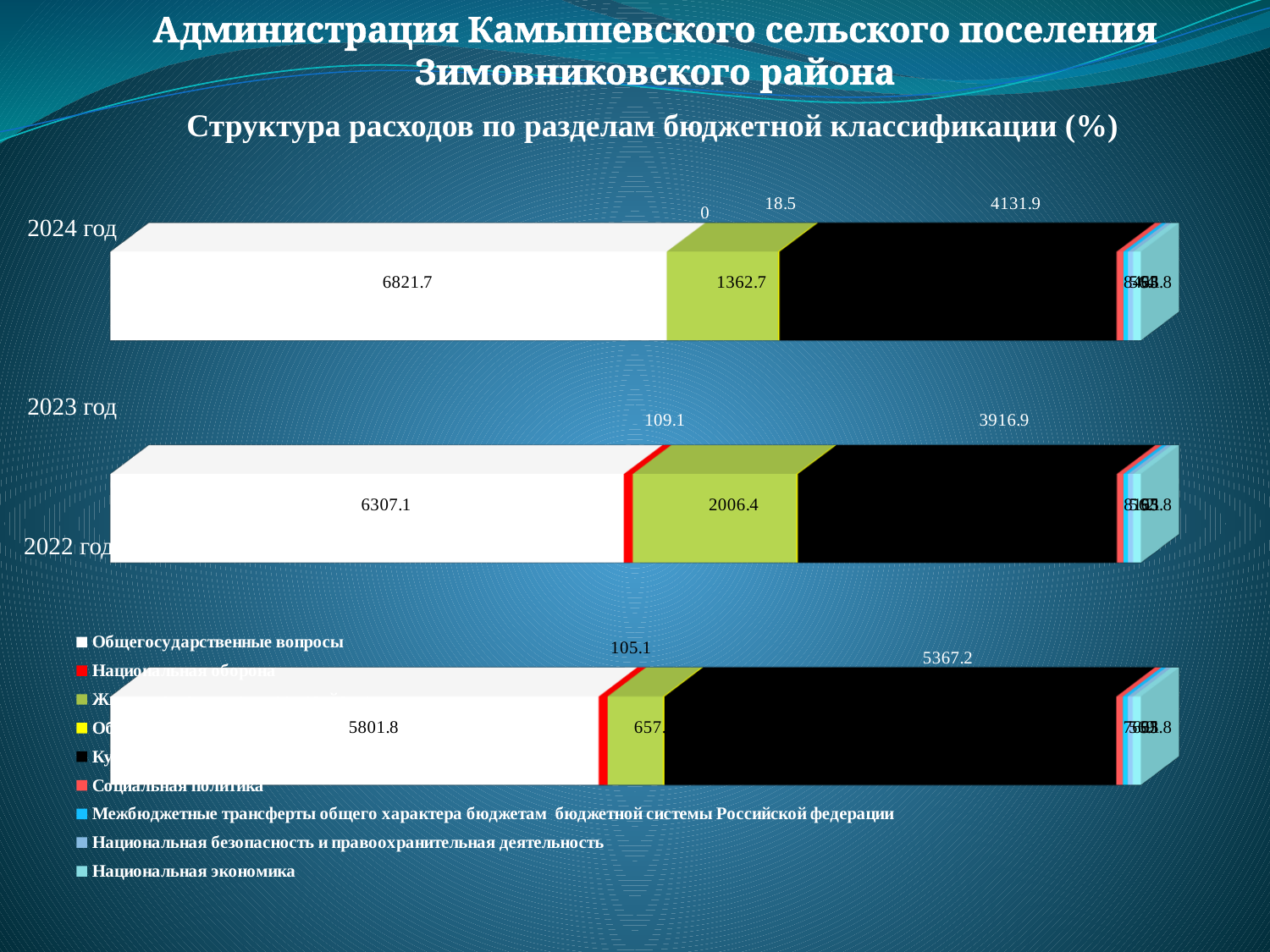
What is the difference between the Общегосударственные вопросы values for 2024 год and 2023 год? 514.6 What is the value for Общегосударственные вопросы in the 2022 год bar? 5801.8 What is the value for Национальная оборона in the 2023 год bar? 109.1 Which year has the larger value for Национальная оборона, 2023 год or 2022 год? 2023 год What kind of chart is shown on the slide? bar chart How many years (bars) are shown in the chart? 3 What is the value of the black segment in the 2022 год bar? 5367.2 What is the value for Общегосударственные вопросы in the 2023 год bar? 6307.1 How many series does the legend list? 9 What is the value for Общегосударственные вопросы in the 2024 год bar? 6821.7 What is the value for Национальная оборона in the 2022 год bar? 105.1 Which year has the highest value for Общегосударственные вопросы? 2024 год